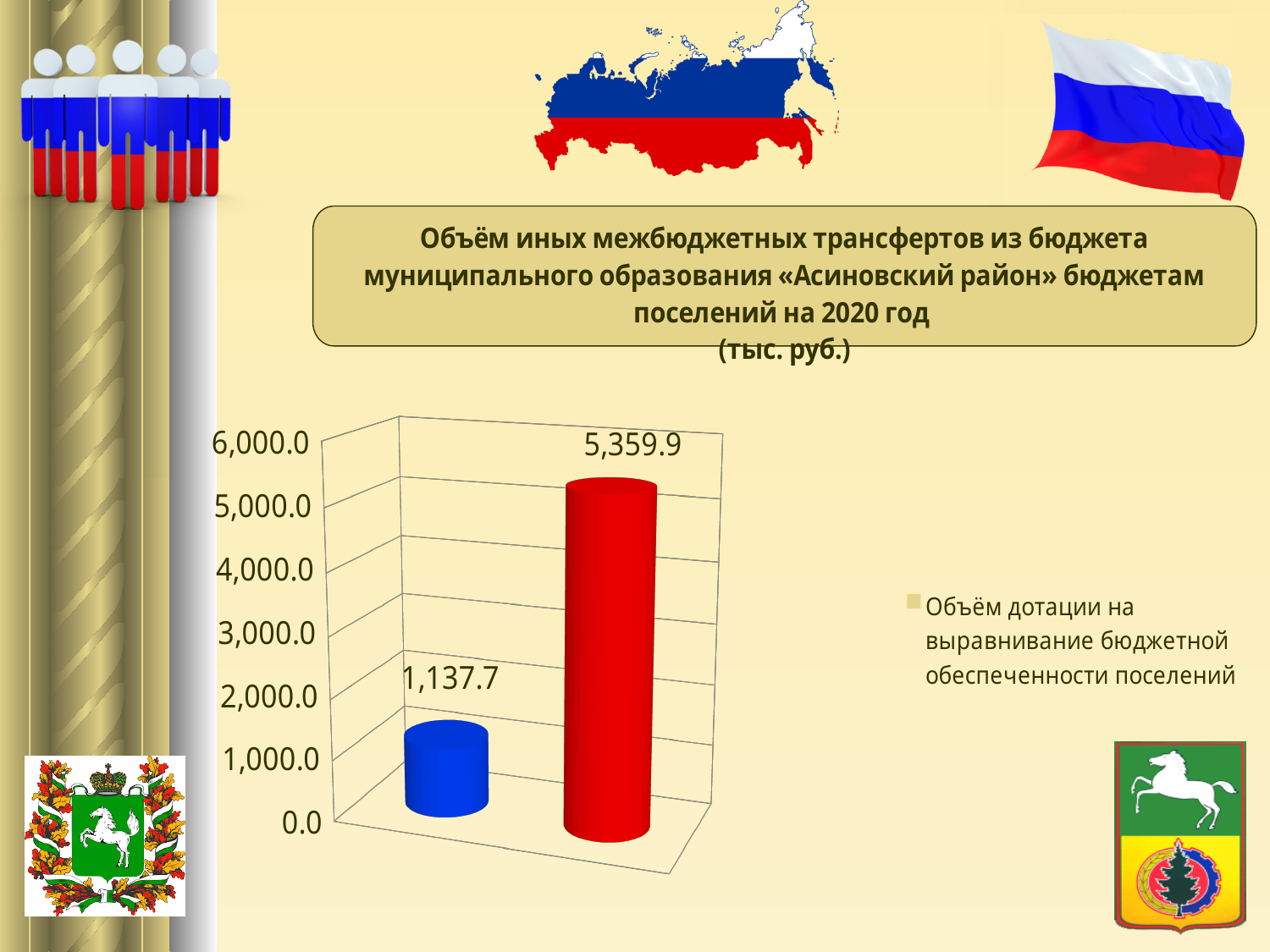
Is the value for the blue bar greater or less than 2,000.0? less Which bar has the lowest value, the blue one or the red one? the blue bar What is the difference between the red bar's value and the blue bar's value? 4,222.2 What kind of chart is shown on the slide? bar chart Is the value of the red bar larger or smaller than the value of the blue bar? larger Which bar has the highest value, the blue one or the red one? the red bar How many entries does the legend list? 1 What value is printed above the red bar? 5,359.9 What is the highest value shown on the vertical axis of the chart? 6,000.0 Is the value for the red bar greater or less than 5,000.0? greater How many bars are plotted in the chart? 2 What value is printed above the blue bar? 1,137.7